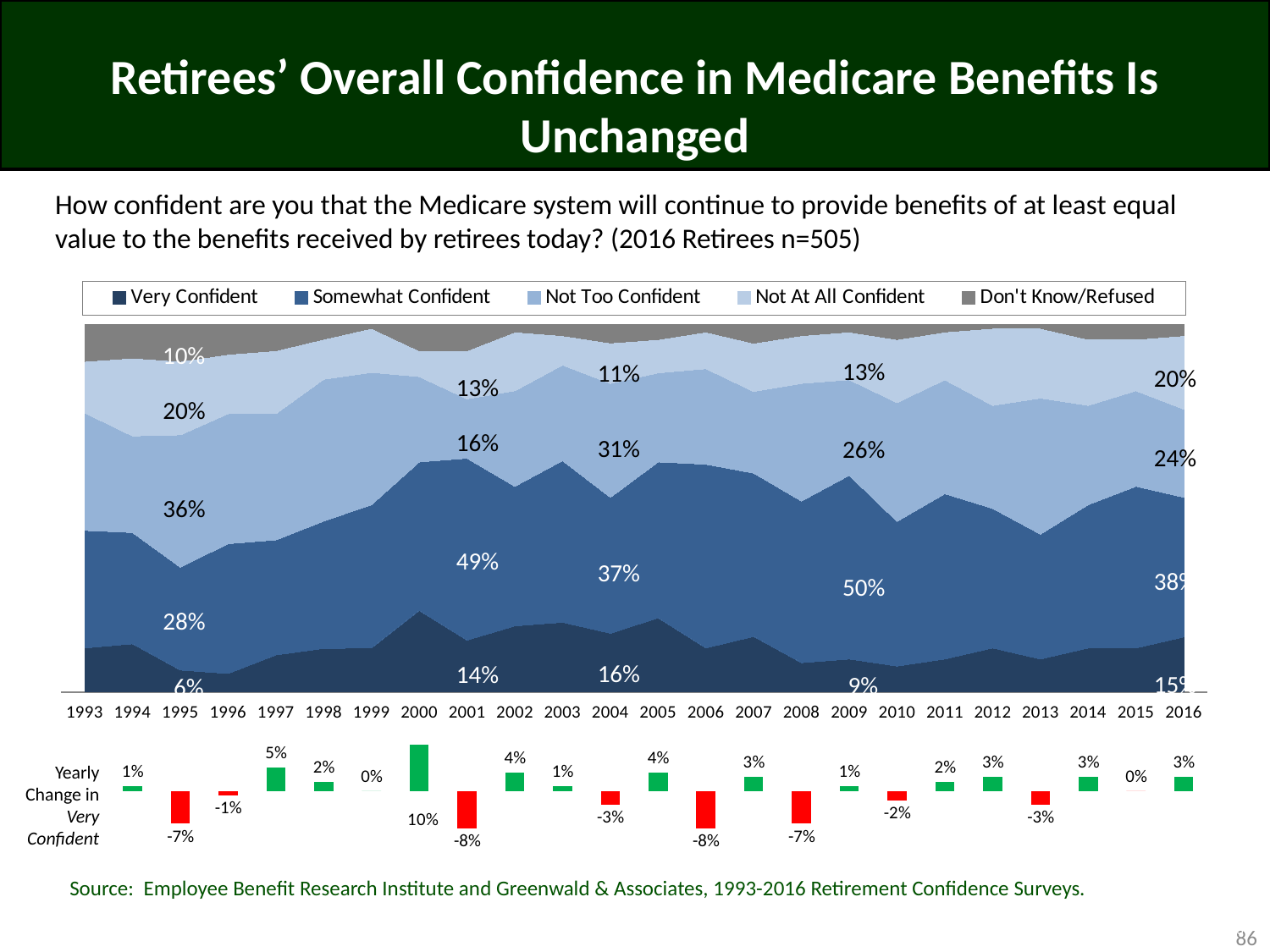
In the stacked area chart, what is the difference between the Somewhat Confident share in 2009 and in 2016? 12 percentage points In the stacked area chart, which is larger: the Very Confident share in 2001 or in 2009? 2001 In the stacked area chart, what percentage of retirees were Very Confident in 1995? 6% In the stacked area chart, what percentage of retirees were Very Confident in 2001? 14% In the 'Yearly Change in Very Confident' bar chart, what is the value for 2008? -7% In the stacked area chart, what percentage of retirees were Somewhat Confident in 2009? 50% How many years are shown on the x axis of the stacked area chart? 24 In the stacked area chart, what percentage of retirees were Not At All Confident in 2016? 20% In the stacked area chart, what percentage of retirees were Not Too Confident in 2004? 31% In the 'Yearly Change in Very Confident' bar chart, which year has the largest increase? 2000 What kind of chart is the main chart showing confidence levels from 1993 to 2016? Stacked area chart How many series does the legend of the stacked area chart list? 5